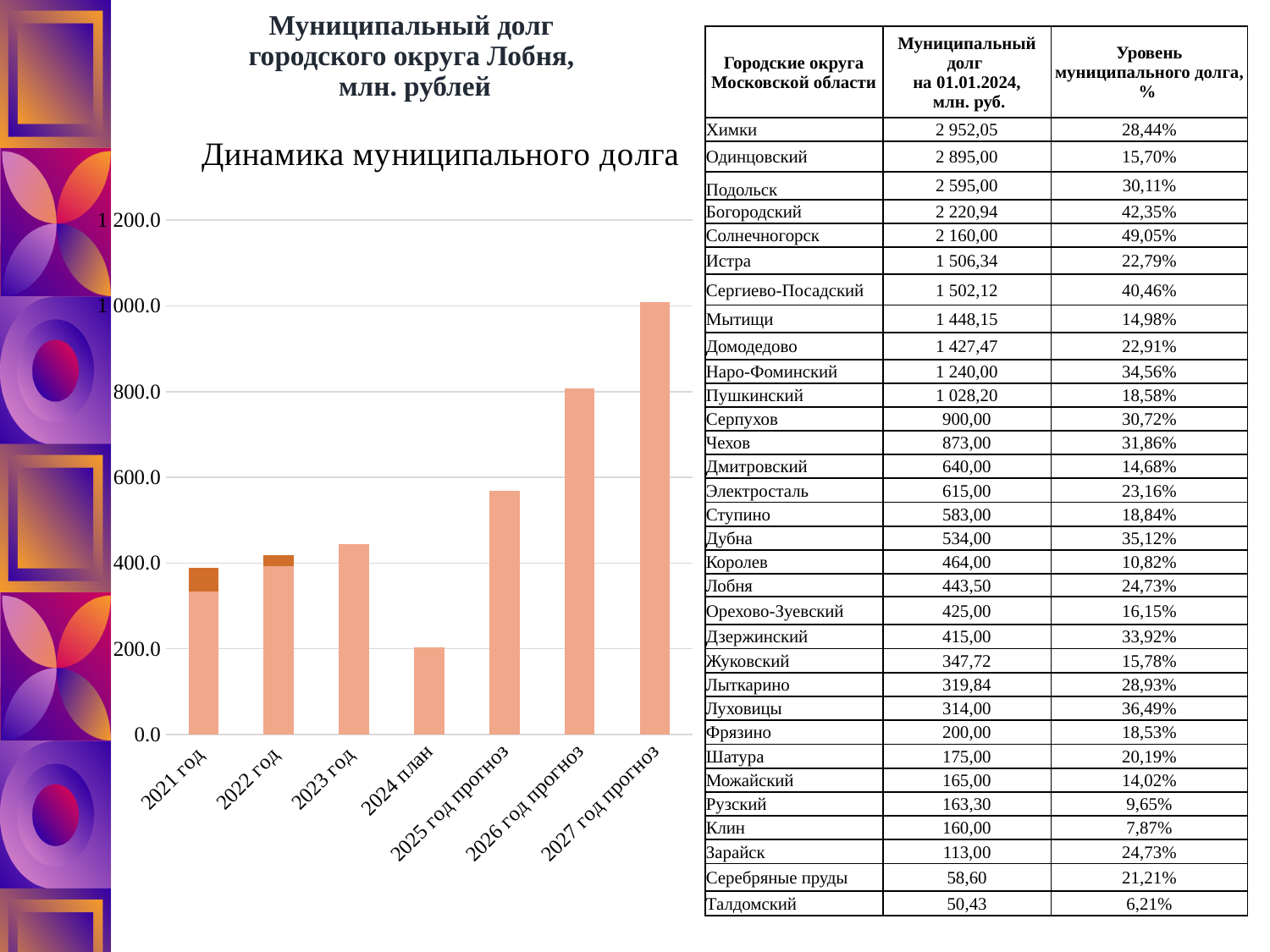
Is the value for 2025 год прогноз greater or less than 400.0? greater Which is larger, the bar for 2025 год прогноз or the bar for 2026 год прогноз? 2026 год прогноз What kind of chart is shown under the heading "Динамика муниципального долга"? bar chart Is the value for 2027 год прогноз greater or less than 800.0? greater Is the value for 2026 год прогноз greater or less than 600.0? greater Which category has the lowest bar in the chart? 2024 план How many categories are shown on the x axis of the bar chart? 7 What is the title printed above the chart, giving the units of the data? Муниципальный долг городского округа Лобня, млн. рублей Which category has the highest bar in the chart? 2027 год прогноз Do the bars rise or fall from 2024 план to 2027 год прогноз? rise